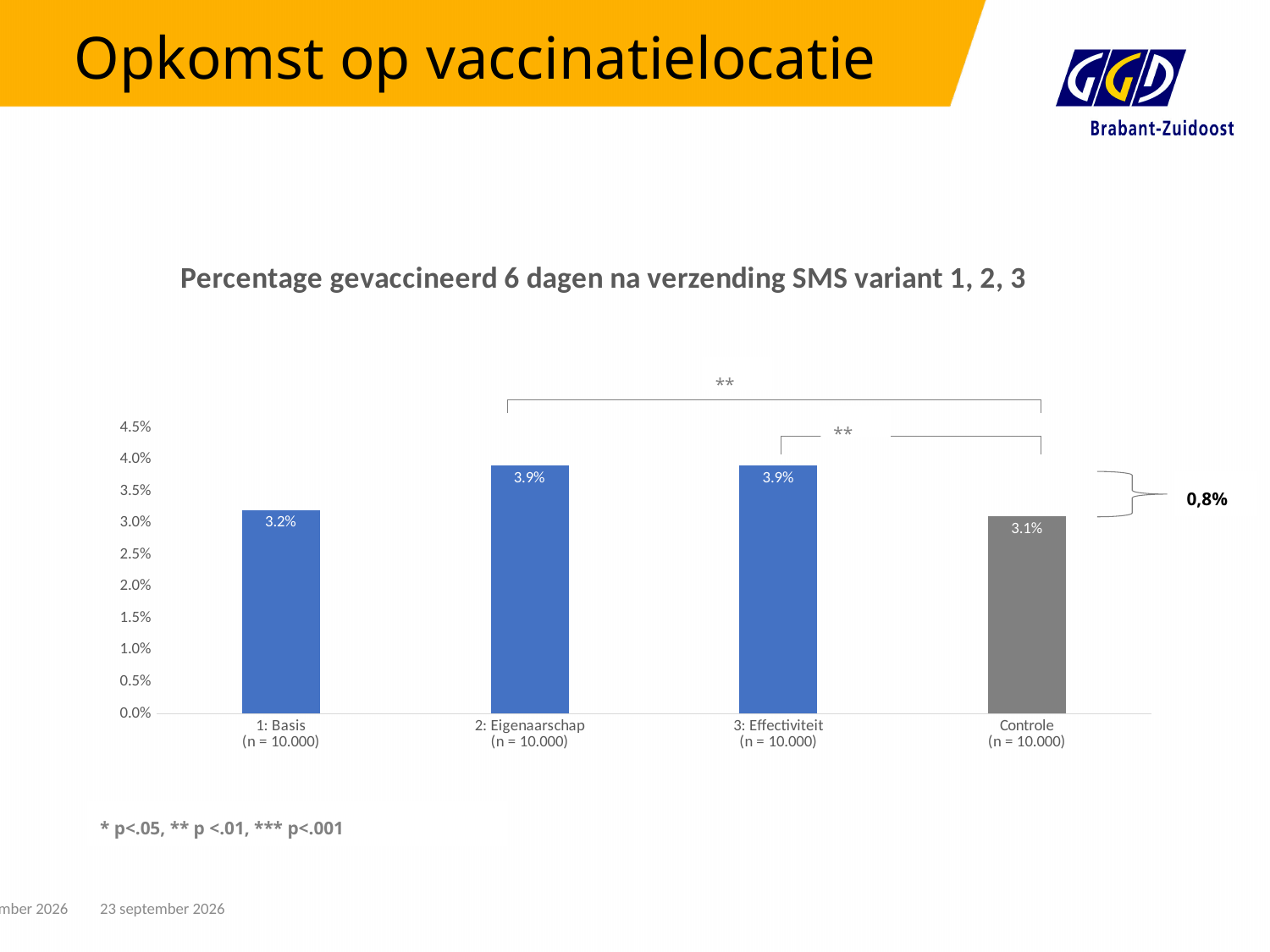
What kind of chart is shown on the slide? bar chart How many categories are shown on the x axis? 4 What is the difference between the values for 2: Eigenaarschap and Controle? 0.8% What is the difference between the values for 3: Effectiviteit and 1: Basis? 0.7% What is the value for Controle? 3.1% Is the value for Controle greater or less than 3.5%? less What is the value for 2: Eigenaarschap? 3.9% Which is larger, the value for 2: Eigenaarschap or the value for 1: Basis? 2: Eigenaarschap What is the value for 1: Basis? 3.2% What is the title of the chart? Percentage gevaccineerd 6 dagen na verzending SMS variant 1, 2, 3 Which category has the lowest value? Controle Is the value for 1: Basis greater or less than 3.0%? greater